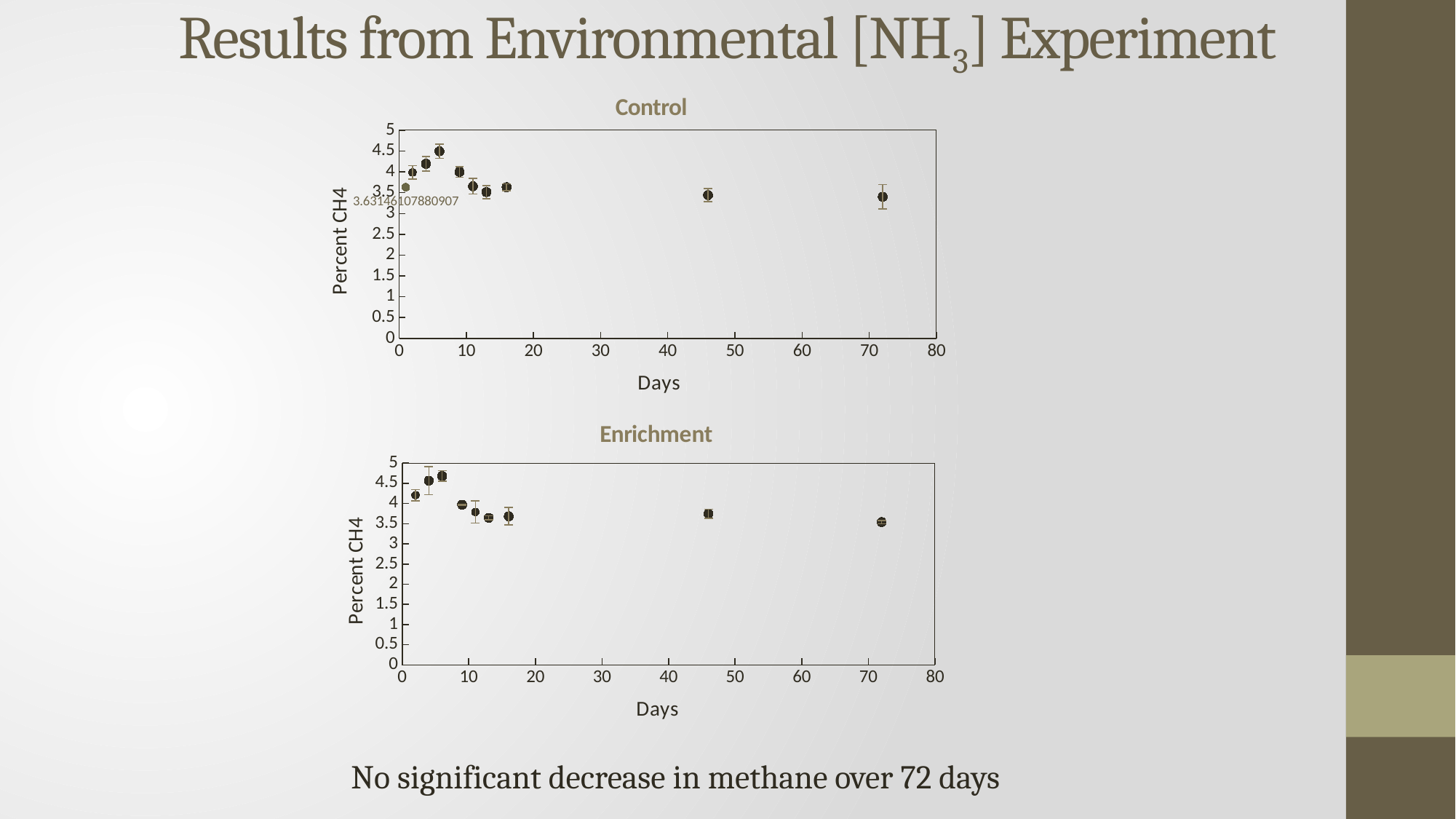
In the Control chart, is the value at day 6 greater or less than 4? greater In the Control chart, what value is printed as a data label on the first point? 3.63146107880907 What kind of chart is the Control chart? scatter chart In the Enrichment chart, is the value at day 72 greater or less than 4? less In the Enrichment chart, at which day is the Percent CH4 value highest? 6 In the Control chart, at which day is the Percent CH4 value highest? 6 What is the title of the top chart? Control In the Enrichment chart, do the values rise or fall from day 6 to day 72? fall In the Enrichment chart, is the value at day 6 greater or less than 4.5? greater What is the y-axis label on the Enrichment chart? Percent CH4 In the Control chart, which is larger: the value at day 6 or the value at day 72? day 6